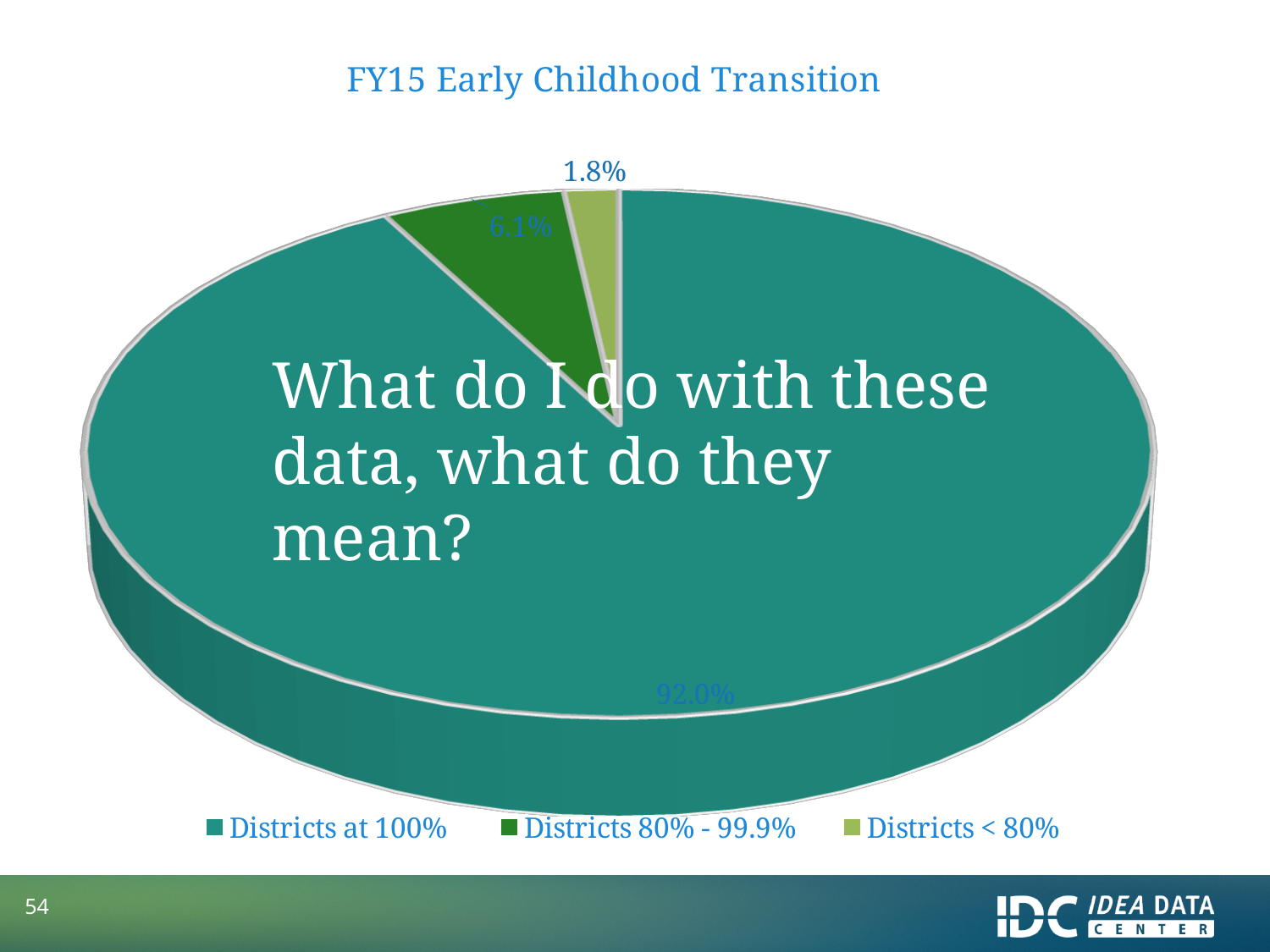
What is the difference between the Districts at 100% slice and the Districts 80% - 99.9% slice? 85.9% Which category has the largest slice of the pie? Districts at 100% Which is larger, the Districts 80% - 99.9% slice or the Districts < 80% slice? Districts 80% - 99.9% What percentage of the pie is labelled for Districts < 80%? 1.8% How many categories does the legend list? 3 Which category has the smallest slice of the pie? Districts < 80% What is the difference between the Districts 80% - 99.9% slice and the Districts < 80% slice? 4.3% What percentage of the pie is labelled for Districts 80% - 99.9%? 6.1% What percentage of the pie is labelled for Districts at 100%? 92.0% Which legend entry is shown in the lightest green colour? Districts < 80% What is the title of the chart? FY15 Early Childhood Transition What kind of chart is shown on the slide? pie chart